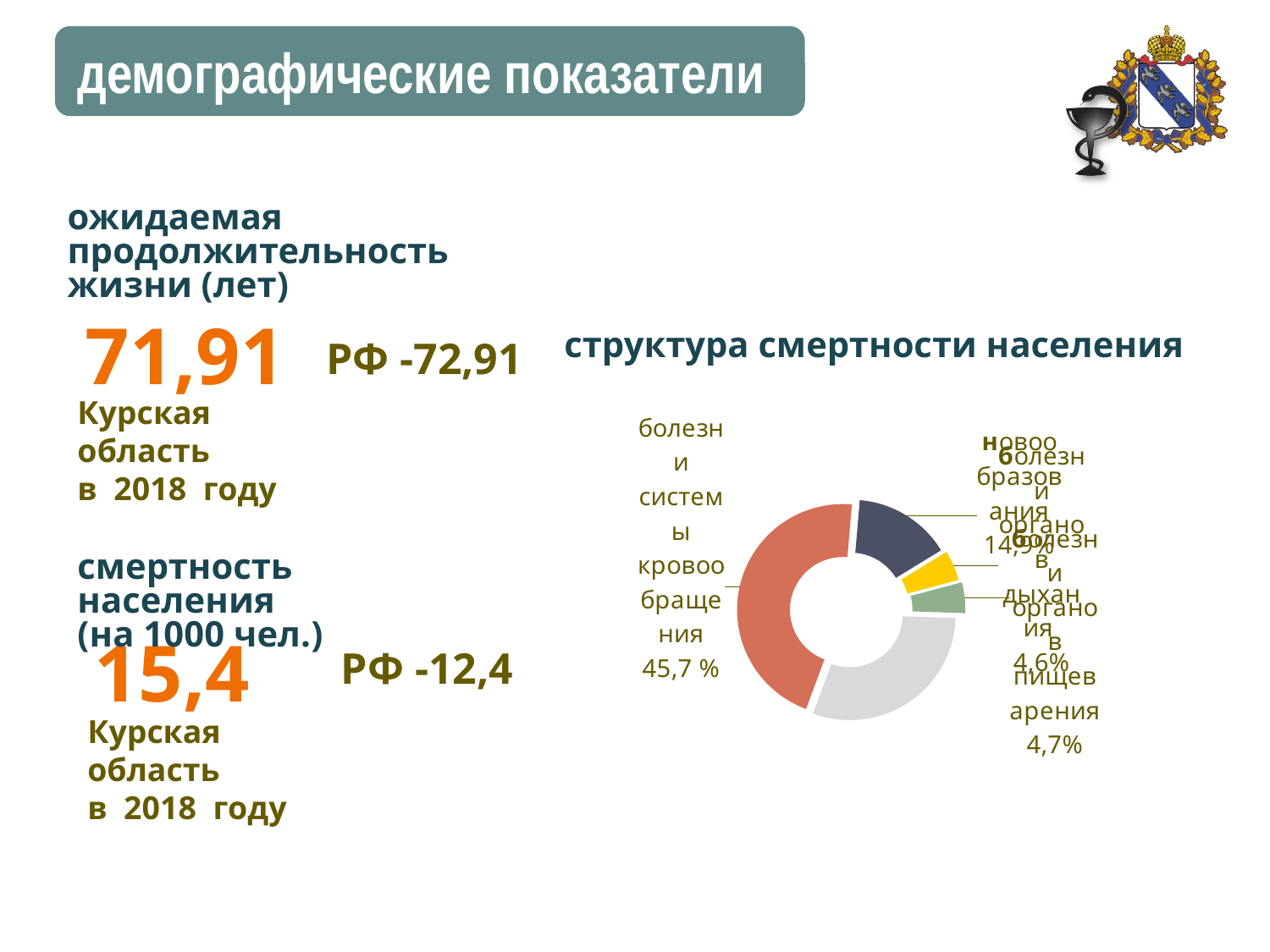
In the "структура смертности населения" chart, what colour is the slice for болезни системы кровообращения? orange-red What is the title of the chart on the right side of the slide? структура смертности населения In the "структура смертности населения" chart, what share is shown for болезни системы кровообращения? 45,7 % How many slices does the "структура смертности населения" doughnut chart have? 5 In the "структура смертности населения" chart, which labelled category has the largest slice? болезни системы кровообращения What kind of chart is shown under the title "структура смертности населения"? doughnut (pie) chart In the "структура смертности населения" chart, what share is shown for болезни органов пищеварения? 4,7% In the "структура смертности населения" chart, which is larger: the slice for болезни системы кровообращения or the slice for новообразования? болезни системы кровообращения In the "структура смертности населения" chart, what share is shown for новообразования? 14,9% In the "структура смертности населения" chart, what share is shown for болезни органов дыхания? 4,6% In the "структура смертности населения" chart, by how many percentage points does болезни системы кровообращения exceed новообразования? 30,8